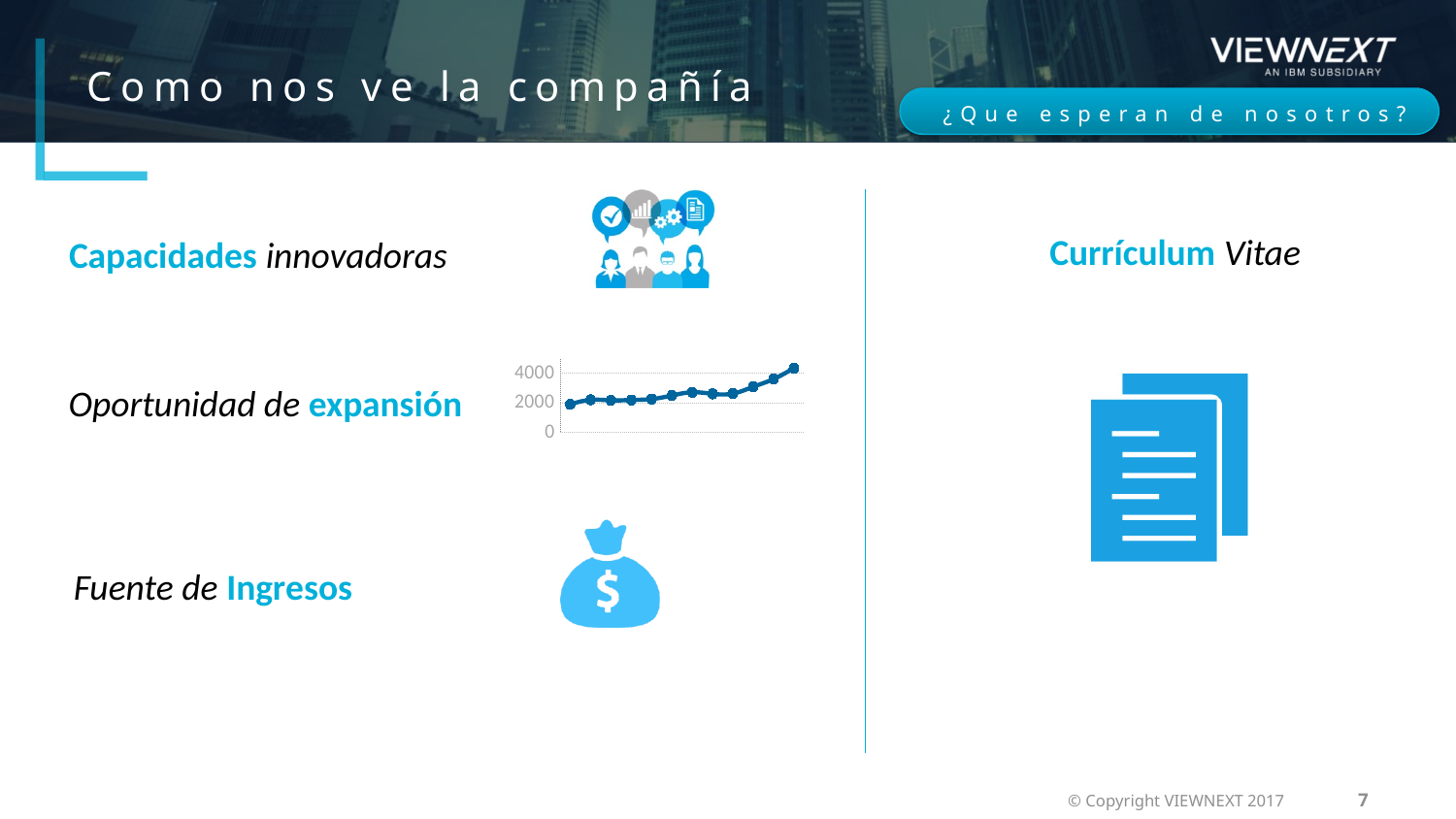
How many tick labels are shown on the y-axis of the line chart next to "Oportunidad de expansión"? 3 In the line chart next to "Oportunidad de expansión", is the rightmost point higher or lower than the leftmost point? higher In the line chart next to "Oportunidad de expansión", is the value of the leftmost point greater or less than 4000? less In the line chart next to "Oportunidad de expansión", is the value of the rightmost point greater or less than 2000? greater What kind of chart is shown next to "Oportunidad de expansión"? line chart In the line chart next to "Oportunidad de expansión", do the values rise or fall from left to right? rise In the line chart next to "Oportunidad de expansión", which point has the highest value, the leftmost or the rightmost? the rightmost What is the highest tick value shown on the y-axis of the line chart next to "Oportunidad de expansión"? 4000